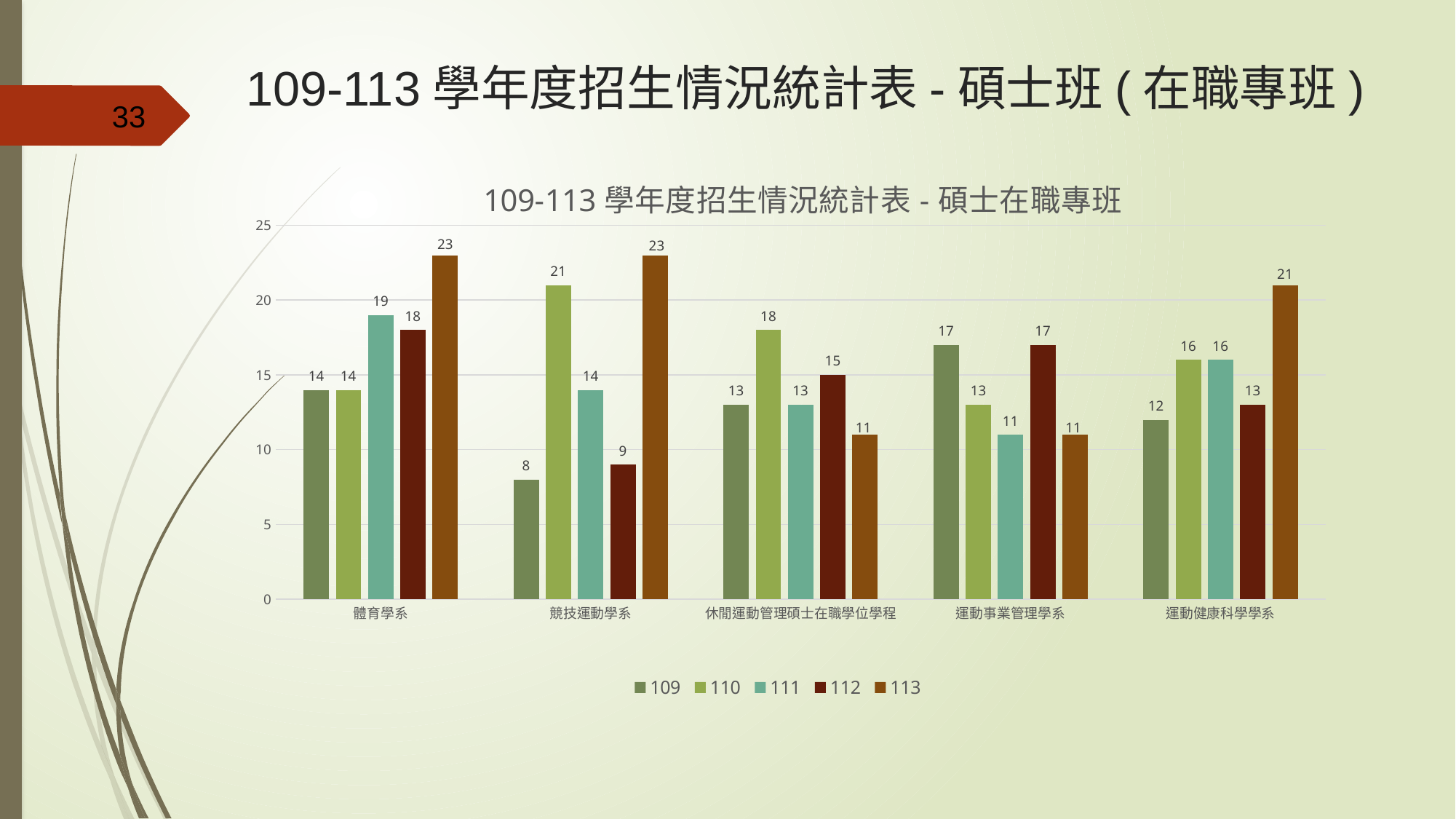
How many series does the legend list? 5 What is the value for 體育學系 in series 113? 23 What is the value for 運動健康科學學系 in series 110? 16 Which category has the highest value in series 110? 競技運動學系 What kind of chart is shown on the slide? Bar chart Which category has the lowest value in series 109? 競技運動學系 How many categories are shown on the x axis? 5 What is the value for 休閒運動管理碩士在職學位學程 in series 112? 15 What is the value for 競技運動學系 in series 109? 8 What is the title of the chart? 109-113 學年度招生情況統計表 - 碩士在職專班 For 運動事業管理學系, which is larger: the value for 109 or the value for 111? 109 What is the difference between the 113 value and the 109 value for 競技運動學系? 15